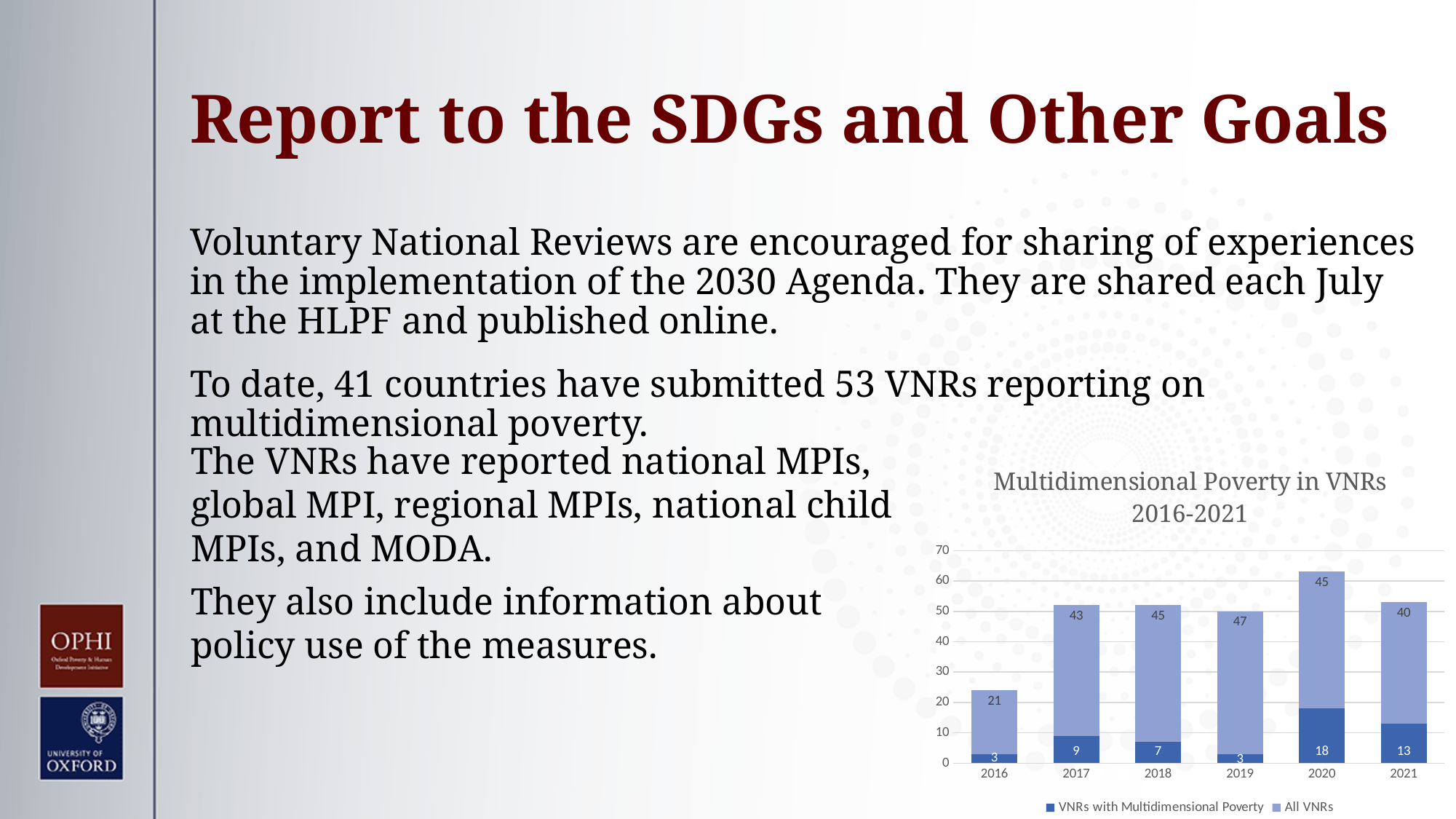
What is the value for All VNRs in 2017? 43 Which year has the lowest value for All VNRs? 2016 What is the difference between the VNRs with Multidimensional Poverty values for 2020 and 2021? 5 What is the title of the chart? Multidimensional Poverty in VNRs 2016-2021 What is the value for VNRs with Multidimensional Poverty in 2020? 18 What type of chart is shown on the slide? Stacked bar chart Which year has the highest value for VNRs with Multidimensional Poverty? 2020 How many series does the chart legend list? 2 Which is larger: the All VNRs value for 2018 or for 2021? 2018 How many years are shown on the x axis of the chart? 6 Which year has the highest value for All VNRs? 2019 What is the total of the stacked bar for 2020? 63